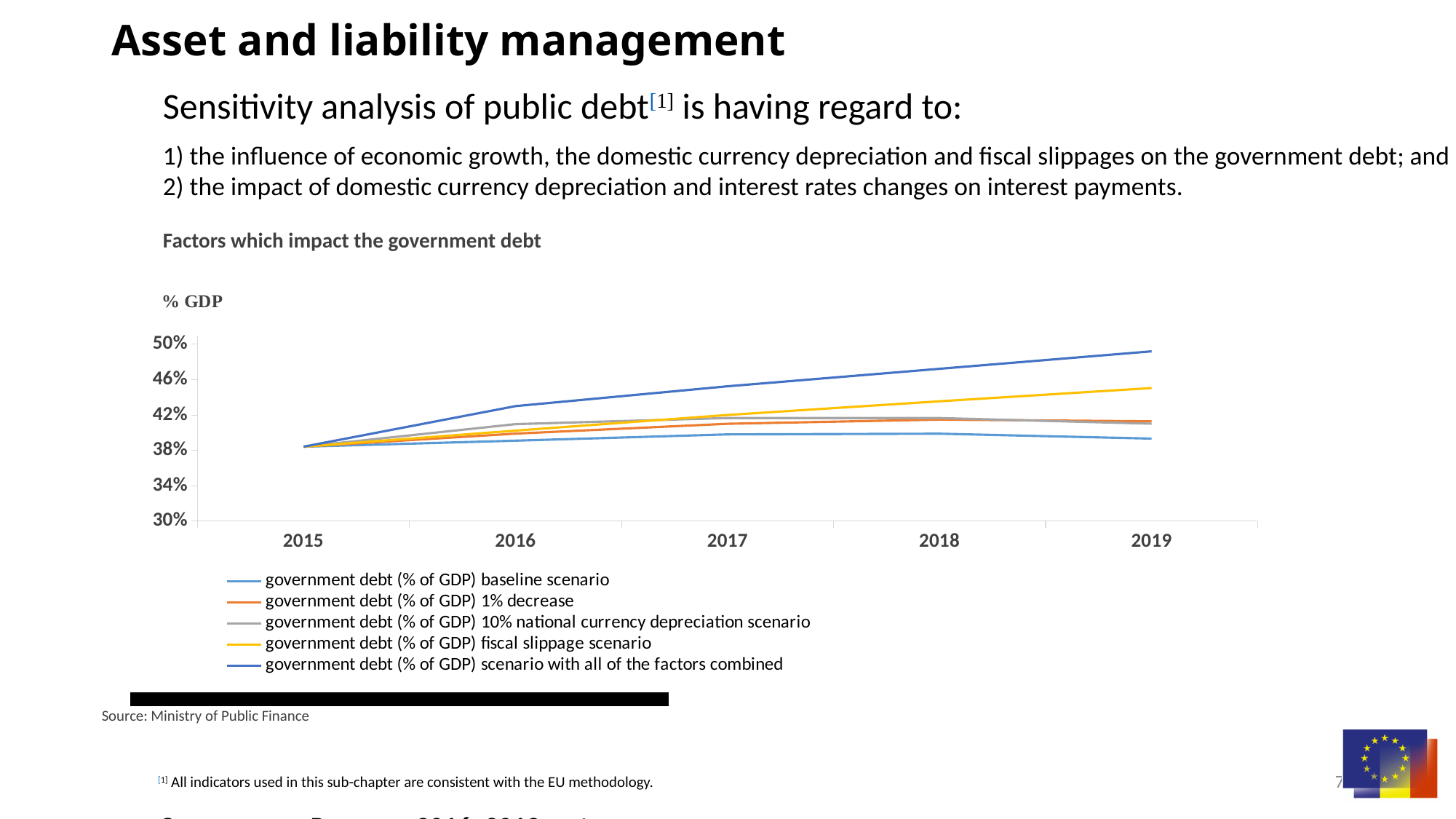
What is the title of the chart? Factors which impact the government debt Which scenario has the lowest government debt in 2019? baseline scenario What unit label is shown on the y axis of the chart? % GDP Is the 2019 value for the scenario with all of the factors combined greater or less than 46%? greater In 2019, which is larger: the fiscal slippage scenario or the baseline scenario? fiscal slippage scenario How many series does the legend of the chart list? 5 Is the 2019 value for the fiscal slippage scenario greater or less than 42%? greater Which scenario has the highest government debt in 2019? scenario with all of the factors combined What kind of chart is shown under the title 'Factors which impact the government debt'? line chart How many years are shown on the x axis of the chart? 5 Is the 2019 value for the baseline scenario greater or less than 42%? less Does the government debt in the scenario with all of the factors combined rise or fall from 2015 to 2019? rise